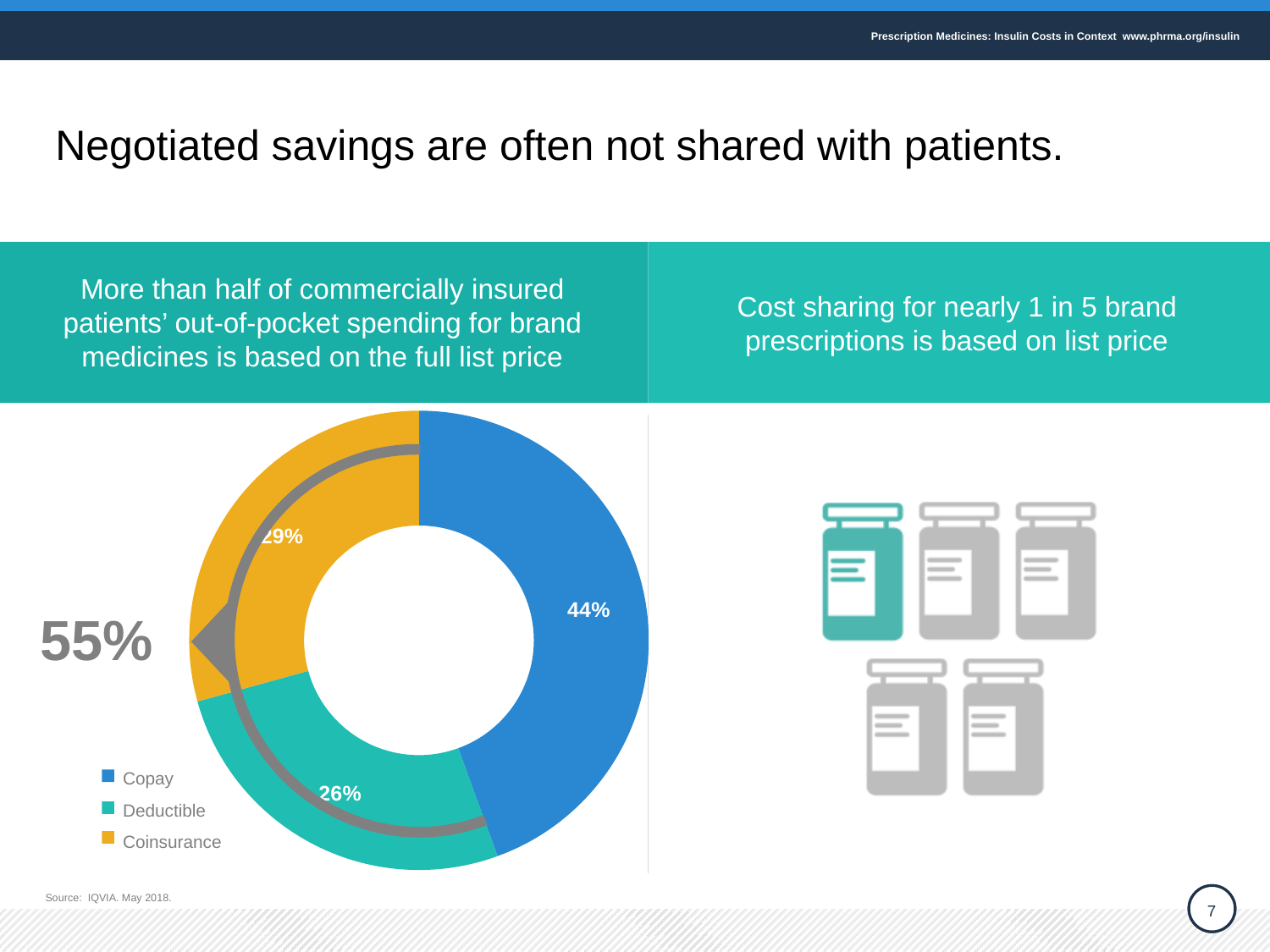
What is the combined share of Deductible and Coinsurance in the donut chart? 55% What percentage of the donut chart is Deductible? 26% Which category has the smallest share of the donut chart? Deductible How many entries does the legend of the donut chart list? 3 What percentage of the donut chart is Coinsurance? 29% What kind of chart is shown on the left side of the slide? donut chart What colour represents Copay in the donut chart? blue How many percentage points larger is Copay than Deductible in the donut chart? 18 percentage points Which is larger in the donut chart, Copay or Deductible? Copay Which category has the largest share of the donut chart? Copay How many categories are shown in the donut chart? 3 What percentage of the donut chart is Copay? 44%